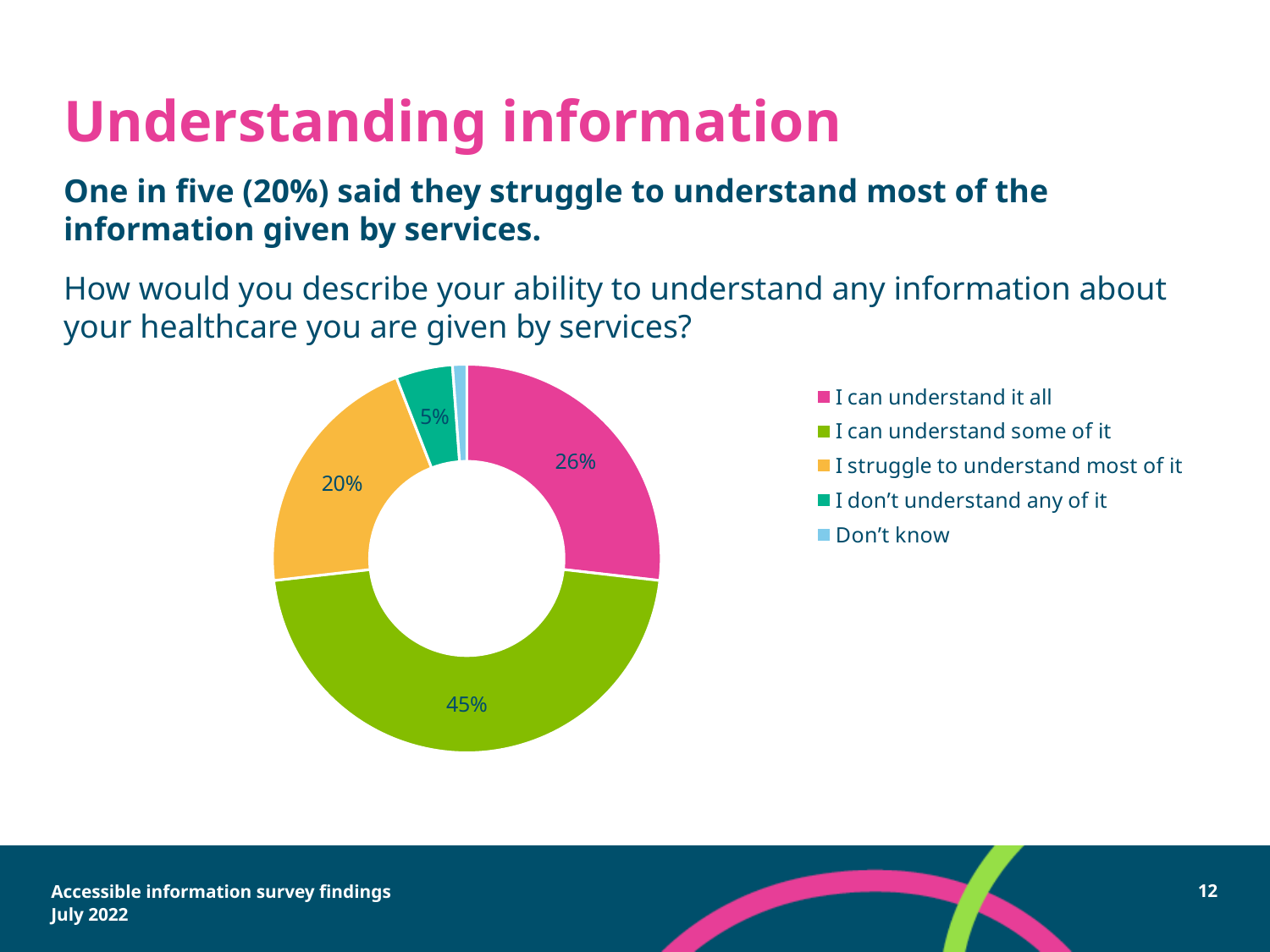
Which response has the largest share of the chart? I can understand some of it What kind of chart is shown on the slide? Pie chart (donut) Which is larger: the share for "I can understand it all" or the share for "I struggle to understand most of it"? I can understand it all What percentage of respondents said "I don't understand any of it"? 5% What percentage of respondents said "I can understand it all"? 26% What percentage of respondents said "I can understand some of it"? 45% What percentage of respondents said "I struggle to understand most of it"? 20% What colour is the slice for "I can understand some of it"? Green How many entries does the legend list? 5 What is the difference in percentage points between "I can understand some of it" and "I can understand it all"? 19 percentage points How many response categories does the chart show? 5 Which response has the smallest share of the chart? Don't know